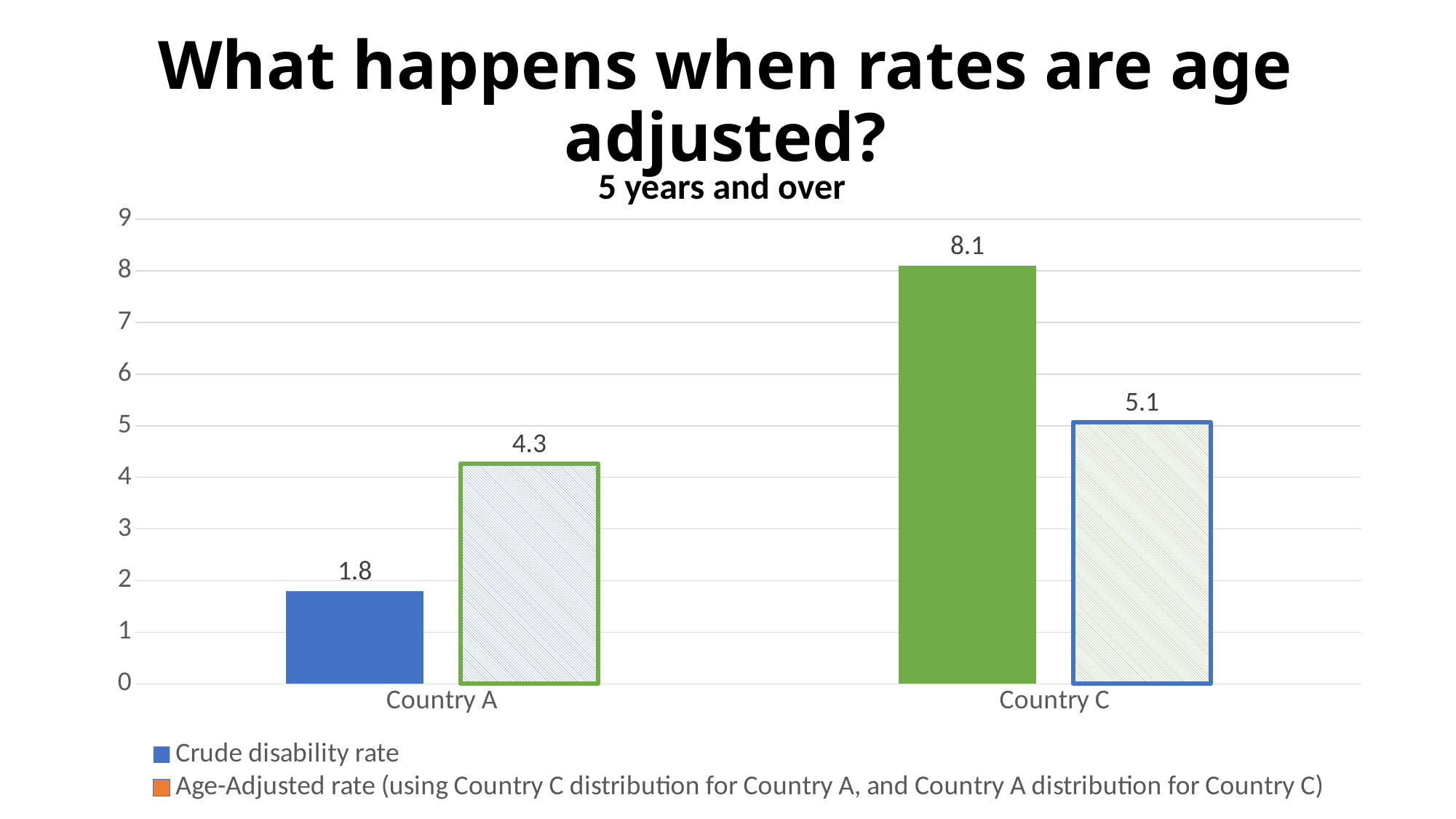
Is the age-adjusted rate for Country A larger or smaller than the age-adjusted rate for Country C? smaller Which bar on the chart has the lowest value? Crude disability rate for Country A What is the age-adjusted rate for Country A? 4.3 What is the crude disability rate for Country C? 8.1 What is the crude disability rate for Country A? 1.8 Which country has the higher crude disability rate? Country C What type of chart is shown on the slide? bar chart How many series does the legend list? 2 What is the difference between the age-adjusted rate and the crude disability rate for Country A? 2.5 What is the difference between the crude disability rate and the age-adjusted rate for Country C? 3 How many countries are shown on the x axis? 2 What is the age-adjusted rate for Country C? 5.1